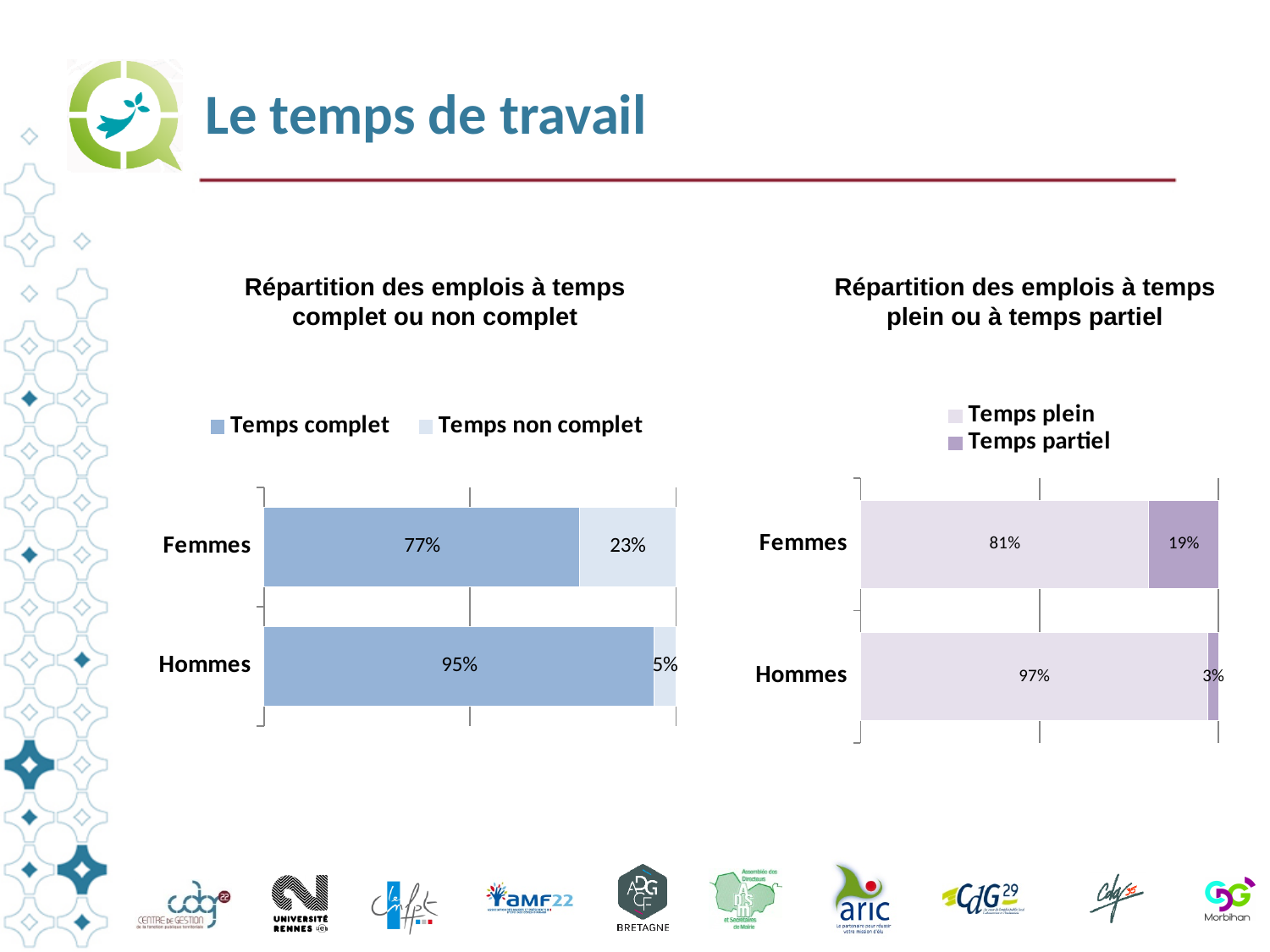
In the chart 'Répartition des emplois à temps complet ou non complet', what is the difference between the Temps complet values for Hommes and Femmes? 18% In the chart 'Répartition des emplois à temps complet ou non complet', is the Temps non complet value larger for Femmes or for Hommes? Femmes In the chart 'Répartition des emplois à temps plein ou à temps partiel', what is the value of Temps partiel for Femmes? 19% In the chart 'Répartition des emplois à temps complet ou non complet', which category has the higher Temps complet value? Hommes In the chart 'Répartition des emplois à temps plein ou à temps partiel', what is the value of Temps plein for Hommes? 97% In the chart 'Répartition des emplois à temps complet ou non complet', what is the value of Temps non complet for Hommes? 5% In the chart 'Répartition des emplois à temps complet ou non complet', what is the value of Temps complet for Femmes? 77% In the chart 'Répartition des emplois à temps plein ou à temps partiel', what is the difference between the Temps partiel values for Femmes and Hommes? 16% In the chart 'Répartition des emplois à temps plein ou à temps partiel', which category has the lower Temps partiel value? Hommes In the chart 'Répartition des emplois à temps complet ou non complet', what is the total of the stacked bar for Femmes? 100% How many series does the legend of the chart 'Répartition des emplois à temps plein ou à temps partiel' list? 2 What kind of chart is 'Répartition des emplois à temps complet ou non complet'? Stacked bar chart